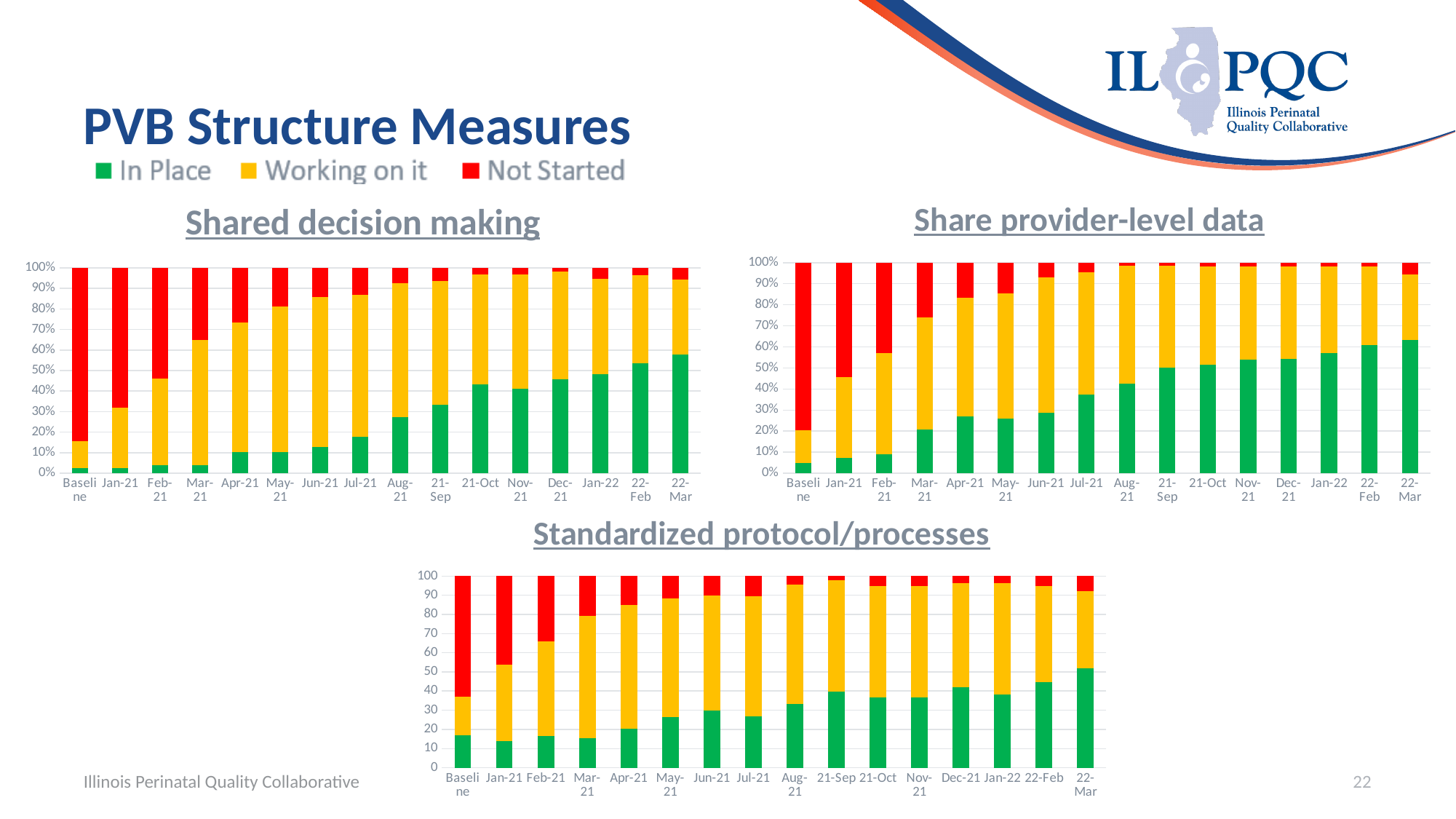
What kind of chart is the "Shared decision making" chart? Stacked bar chart In the "Share provider-level data" chart, does the "Not Started" share rise or fall from Baseline to 22-Mar? Fall How many time-period categories are shown on the x axis of the "Standardized protocol/processes" chart? 16 In the "Share provider-level data" chart, is the "In Place" value for 22-Mar greater or less than 60%? greater In the "Standardized protocol/processes" chart, does the "In Place" share generally rise or fall from Baseline to 22-Mar? Rise In the "Shared decision making" chart, is the "In Place" value for Baseline greater or less than 10%? less Which colour represents "Not Started" in the legend? Red How many series does the legend at the top of the slide list? 3 In the "Share provider-level data" chart, which category has the lowest "In Place" share? Baseline In the "Shared decision making" chart, which category has the highest "In Place" share? 22-Mar In the "Shared decision making" chart, which is larger: the "In Place" share at Baseline or at 22-Mar? 22-Mar